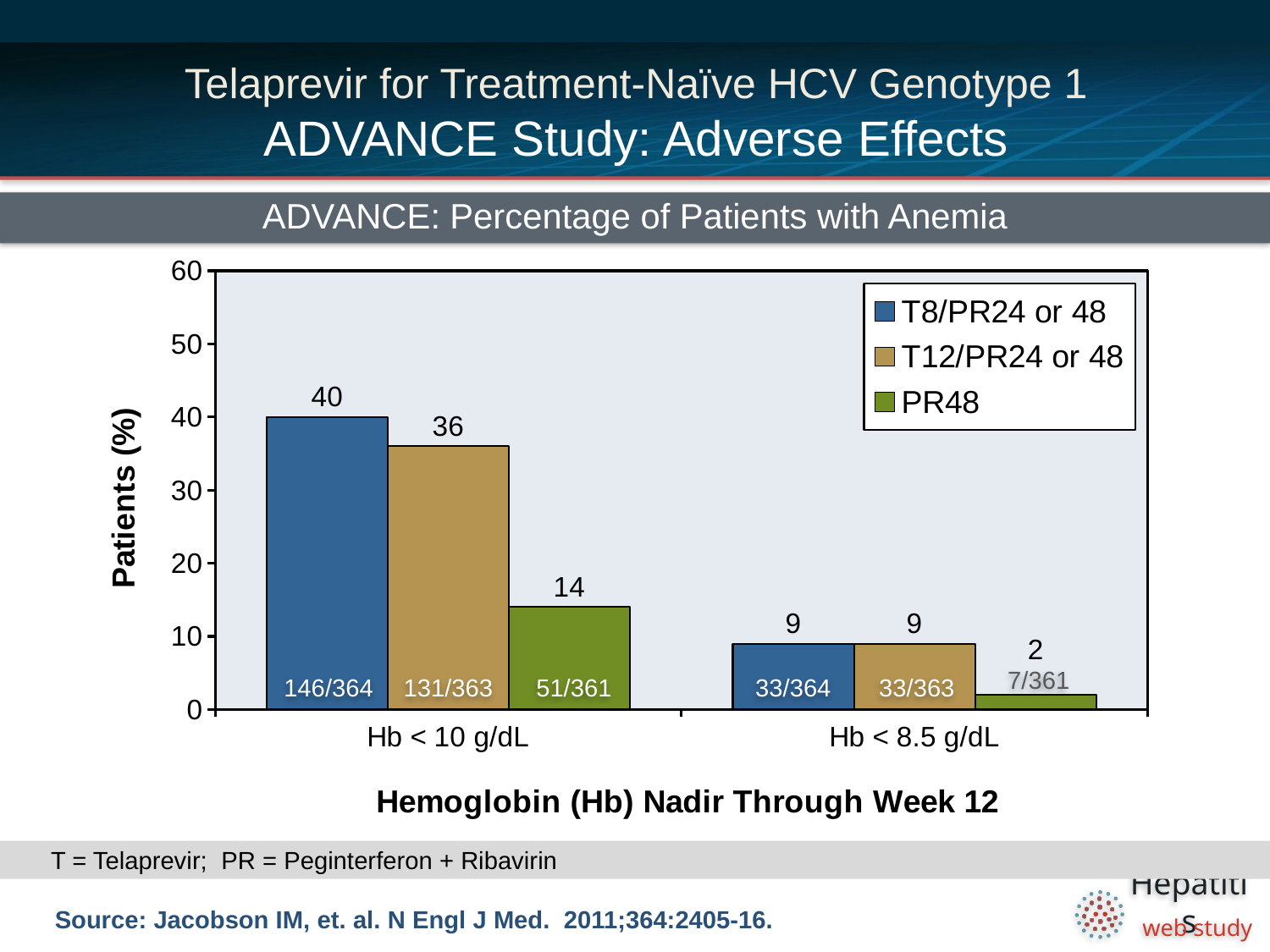
Which treatment group had the lowest percentage of patients with Hb < 8.5 g/dL? PR48 What percentage of patients in the PR48 group had Hb < 8.5 g/dL? 2 What fraction of patients is printed on the PR48 bar for Hb < 10 g/dL? 51/361 How many treatment groups does the legend list? 3 Which is larger: the percentage of T12/PR24 or 48 patients with Hb < 10 g/dL or the percentage of PR48 patients with Hb < 10 g/dL? T12/PR24 or 48 What is the label of the y axis? Patients (%) Which treatment group had the highest percentage of patients with Hb < 10 g/dL? T8/PR24 or 48 How many hemoglobin nadir categories are shown on the x axis? 2 What kind of chart is shown on the slide? Bar chart What percentage of patients in the T12/PR24 or 48 group had Hb < 10 g/dL? 36 What percentage of patients in the T8/PR24 or 48 group had Hb < 10 g/dL? 40 What is the difference in percentage between the T8/PR24 or 48 group and the PR48 group for Hb < 10 g/dL? 26